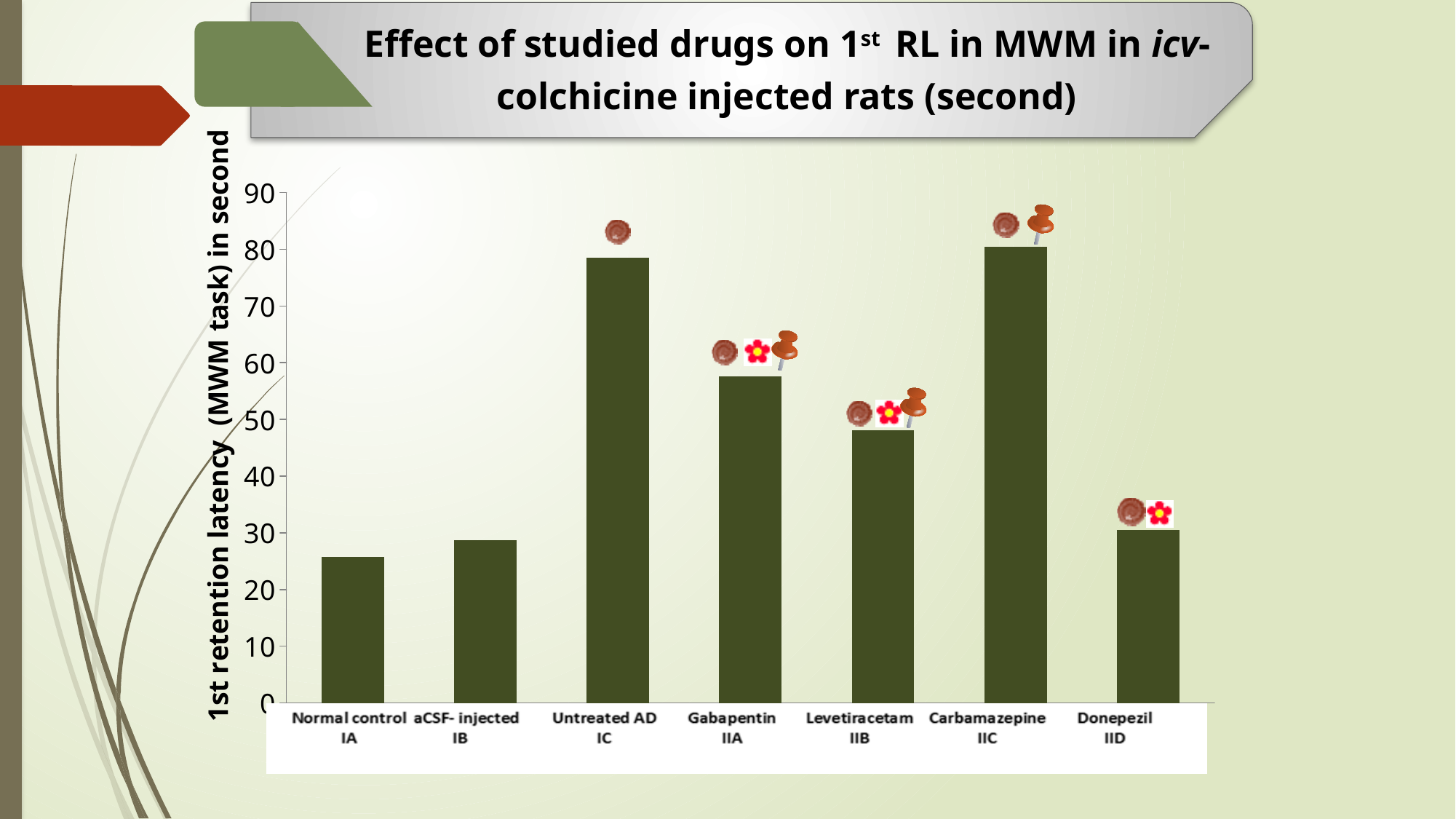
Is the value for Gabapentin IIA greater or less than 50? greater Which has the larger value, Gabapentin IIA or Levetiracetam IIB? Gabapentin IIA Is the value for Untreated AD IC greater or less than 70? greater What is the label of the vertical axis? 1st retention latency (MWM task) in second What is the title of the chart? Effect of studied drugs on 1st RL in MWM in icv-colchicine injected rats (second) Which has the larger value, Untreated AD IC or Donepezil IID? Untreated AD IC Is the value for Normal control IA greater or less than 30? less What kind of chart is shown on the slide? bar chart How many groups (bars) are shown in the chart? 7